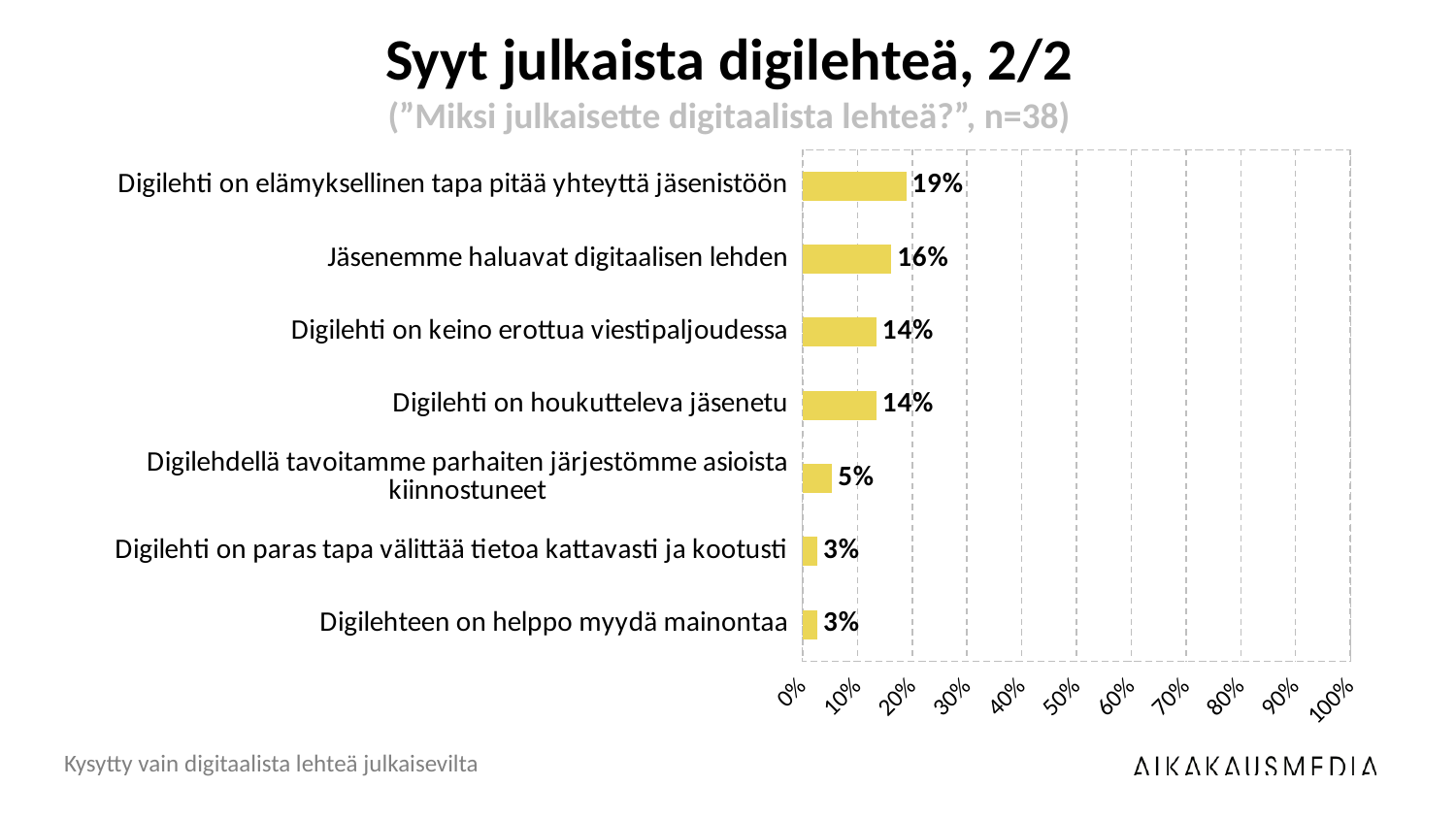
What is the value for "Digilehdellä tavoitamme parhaiten järjestömme asioista kiinnostuneet"? 5% What kind of chart is shown on the slide? bar chart What is the value for "Digilehti on elämyksellinen tapa pitää yhteyttä jäsenistöön"? 19% What is the difference between the values for "Digilehti on elämyksellinen tapa pitää yhteyttä jäsenistöön" and "Jäsenemme haluavat digitaalisen lehden"? 3% What is the value for "Jäsenemme haluavat digitaalisen lehden"? 16% What is the difference between the values for "Digilehti on keino erottua viestipaljoudessa" and "Digilehti on paras tapa välittää tietoa kattavasti ja kootusti"? 11% Which is larger, the value for "Digilehti on houkutteleva jäsenetu" or the value for "Digilehdellä tavoitamme parhaiten järjestömme asioista kiinnostuneet"? Digilehti on houkutteleva jäsenetu What is the value for "Digilehteen on helppo myydä mainontaa"? 3% What is the title of the chart? Syyt julkaista digilehteä, 2/2 How many categories are shown in the chart? 7 Which category has the highest value? Digilehti on elämyksellinen tapa pitää yhteyttä jäsenistöön Is the value for "Jäsenemme haluavat digitaalisen lehden" greater or less than 20%? less